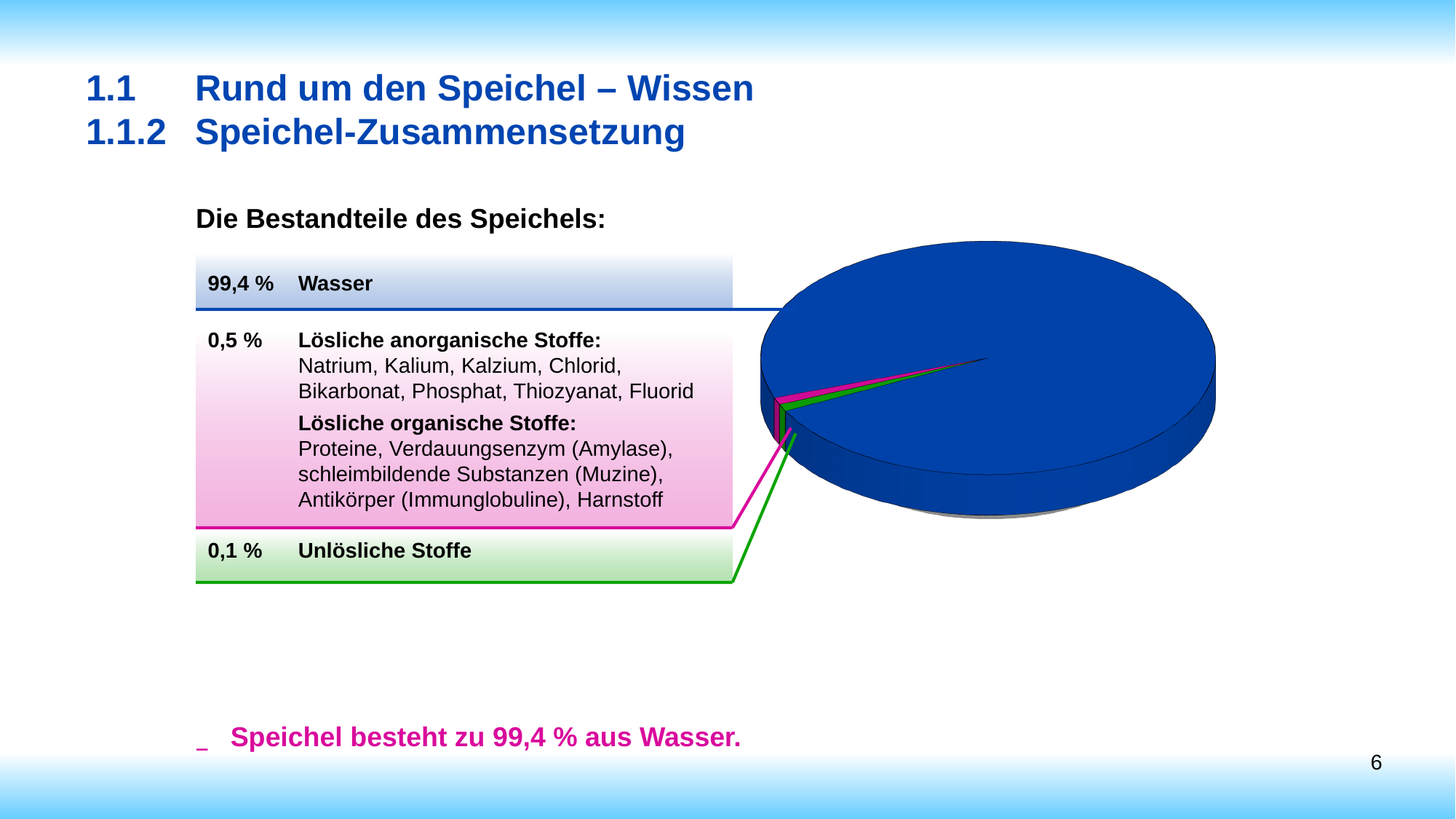
What colour is the Unlösliche Stoffe slice of the pie chart? green What share of saliva does the pie chart show for Wasser? 99,4 % What share is given for Lösliche anorganische und organische Stoffe? 0,5 % Which component has the largest slice of the pie? Wasser Which component has the smallest slice of the pie? Unlösliche Stoffe Which is larger, the share for Lösliche Stoffe or the share for Unlösliche Stoffe? Lösliche Stoffe What is the difference between the share for Wasser and the share for Lösliche Stoffe? 98,9 % What is the difference between the share for Lösliche Stoffe and the share for Unlösliche Stoffe? 0,4 % What kind of chart is shown on the slide? pie chart What share is given for Unlösliche Stoffe? 0,1 % What colour is the Wasser slice of the pie chart? blue How many slices does the pie chart have? 3